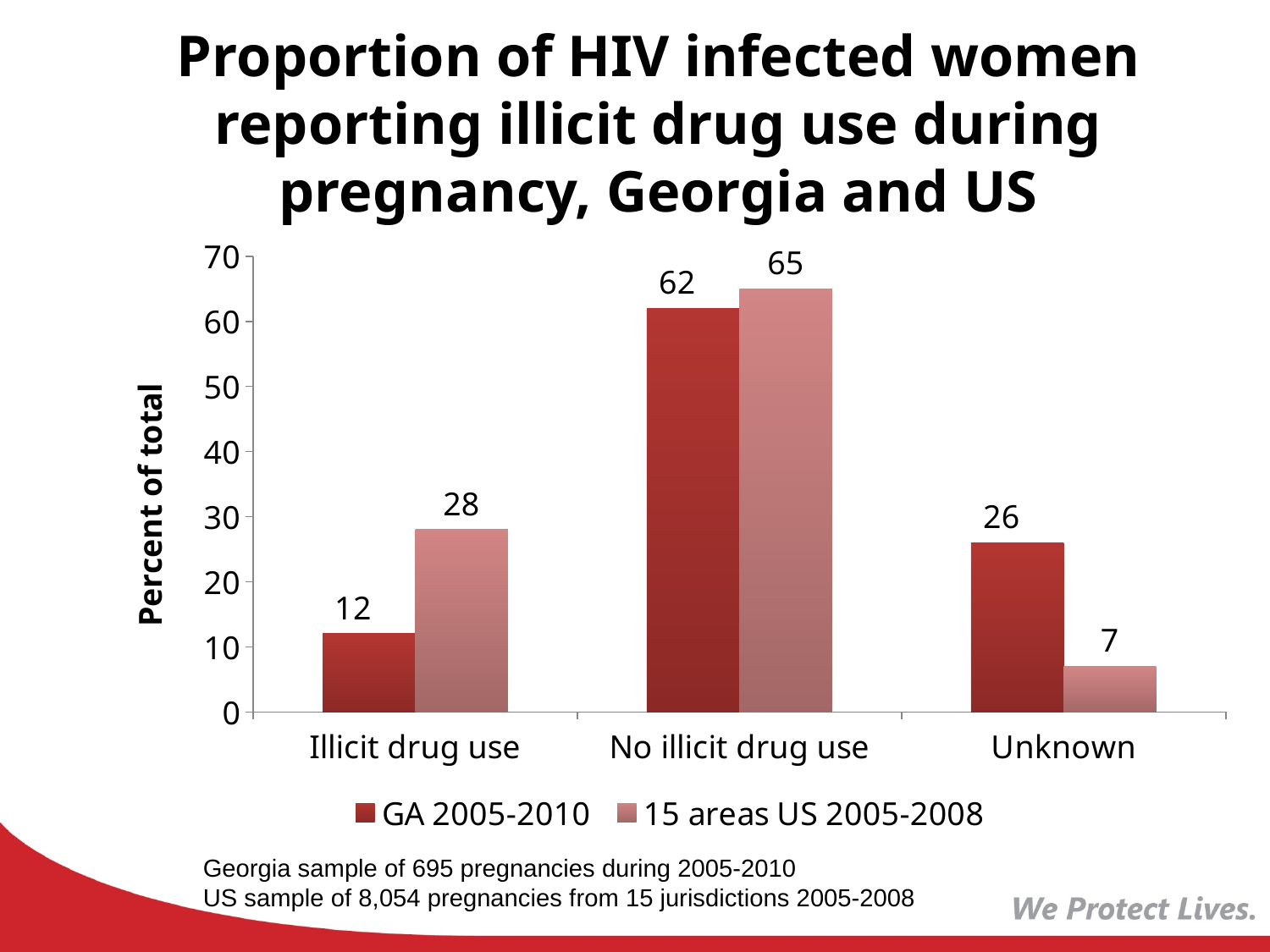
How many categories are shown on the x axis? 3 In the Unknown category, which series has the larger value, GA 2005-2010 or 15 areas US 2005-2008? GA 2005-2010 What is the value for 15 areas US 2005-2008 in the No illicit drug use category? 65 Which category has the highest value for GA 2005-2010? No illicit drug use What is the value for 15 areas US 2005-2008 in the Illicit drug use category? 28 How many series does the legend list? 2 Which category has the lowest value for 15 areas US 2005-2008? Unknown What is the value for GA 2005-2010 in the Illicit drug use category? 12 What is the difference between the 15 areas US 2005-2008 and GA 2005-2010 values in the Illicit drug use category? 16 What is the value for GA 2005-2010 in the Unknown category? 26 What is the label of the y axis? Percent of total What kind of chart is shown on the slide? Bar chart